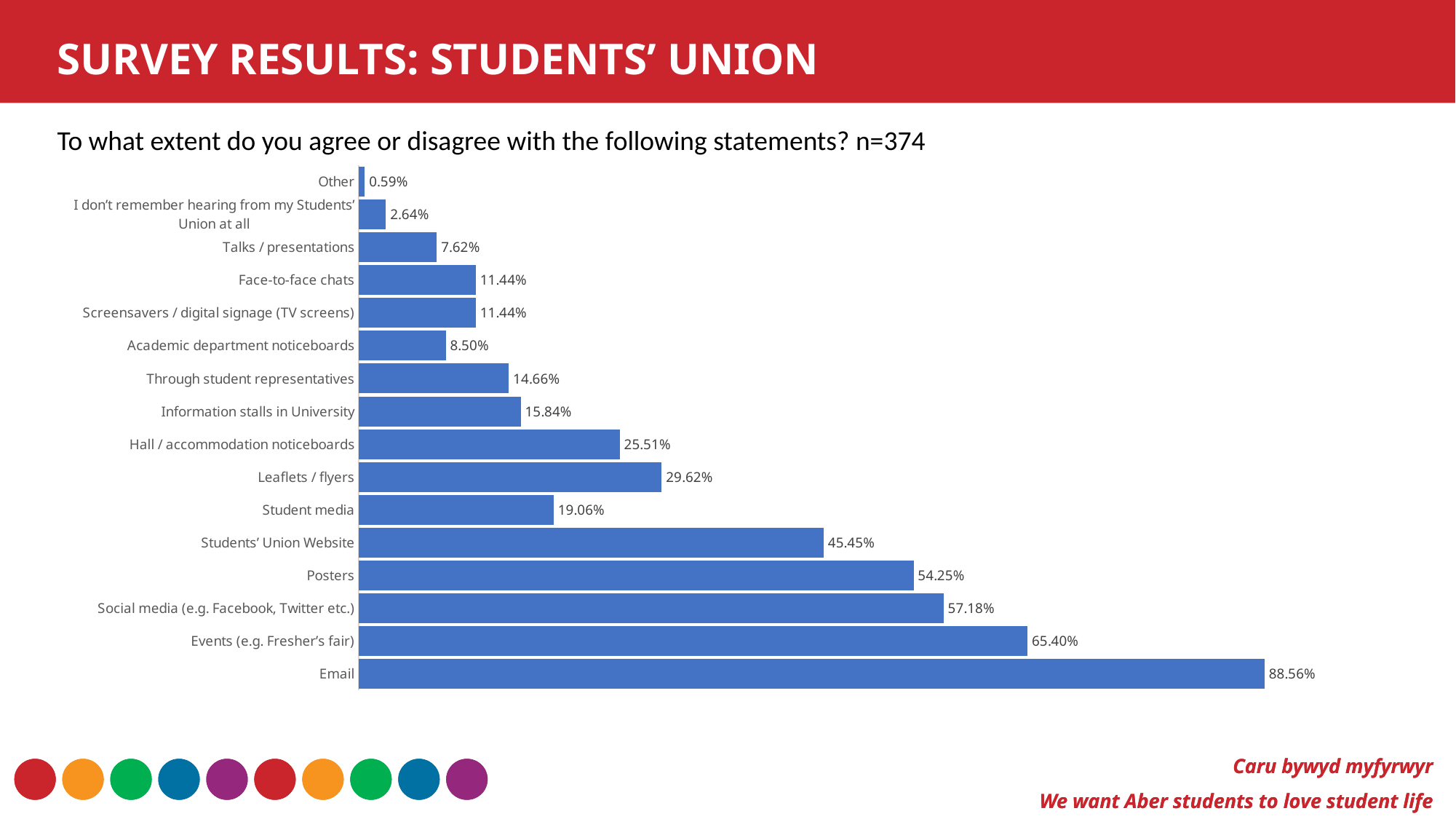
Which is larger, the value for Students' Union Website or the value for Leaflets / flyers? Students' Union Website What kind of chart is shown on the slide? Bar chart What is the sample size (n) stated in the question above the chart? 374 Which category has the lowest value? Other How many categories are shown in the chart? 16 Which category has the highest value? Email What is the value for Posters? 54.25% What is the value for Student media? 19.06% What is the difference between the values for Email and Events (e.g. Fresher's fair)? 23.16% What is the value for Leaflets / flyers? 29.62% What is the difference between the values for Social media (e.g. Facebook, Twitter etc.) and Posters? 2.93% What is the value for Email? 88.56%